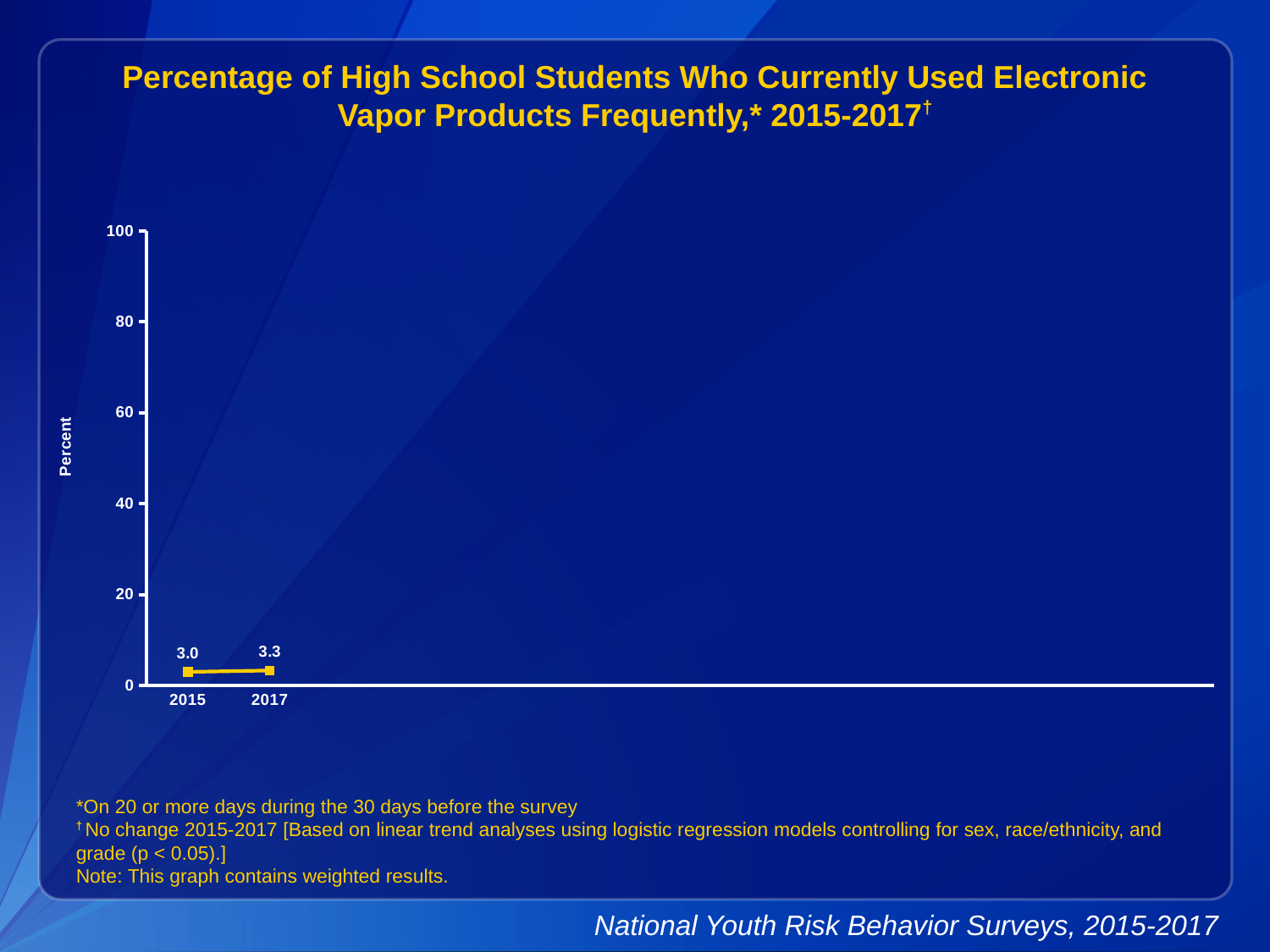
Which year has the lowest value? 2015 What is the difference between the values for 2017 and 2015? 0.3 How many data points are plotted on the chart? 2 Do the values rise or fall from 2015 to 2017? rise What is the value for 2017? 3.3 Which year has the higher value, 2015 or 2017? 2017 Is the value for 2017 greater or less than 20? less What is the value for 2015? 3.0 What is the maximum value shown on the y axis? 100 What kind of chart is shown on the slide? line chart What is the label on the y axis? Percent